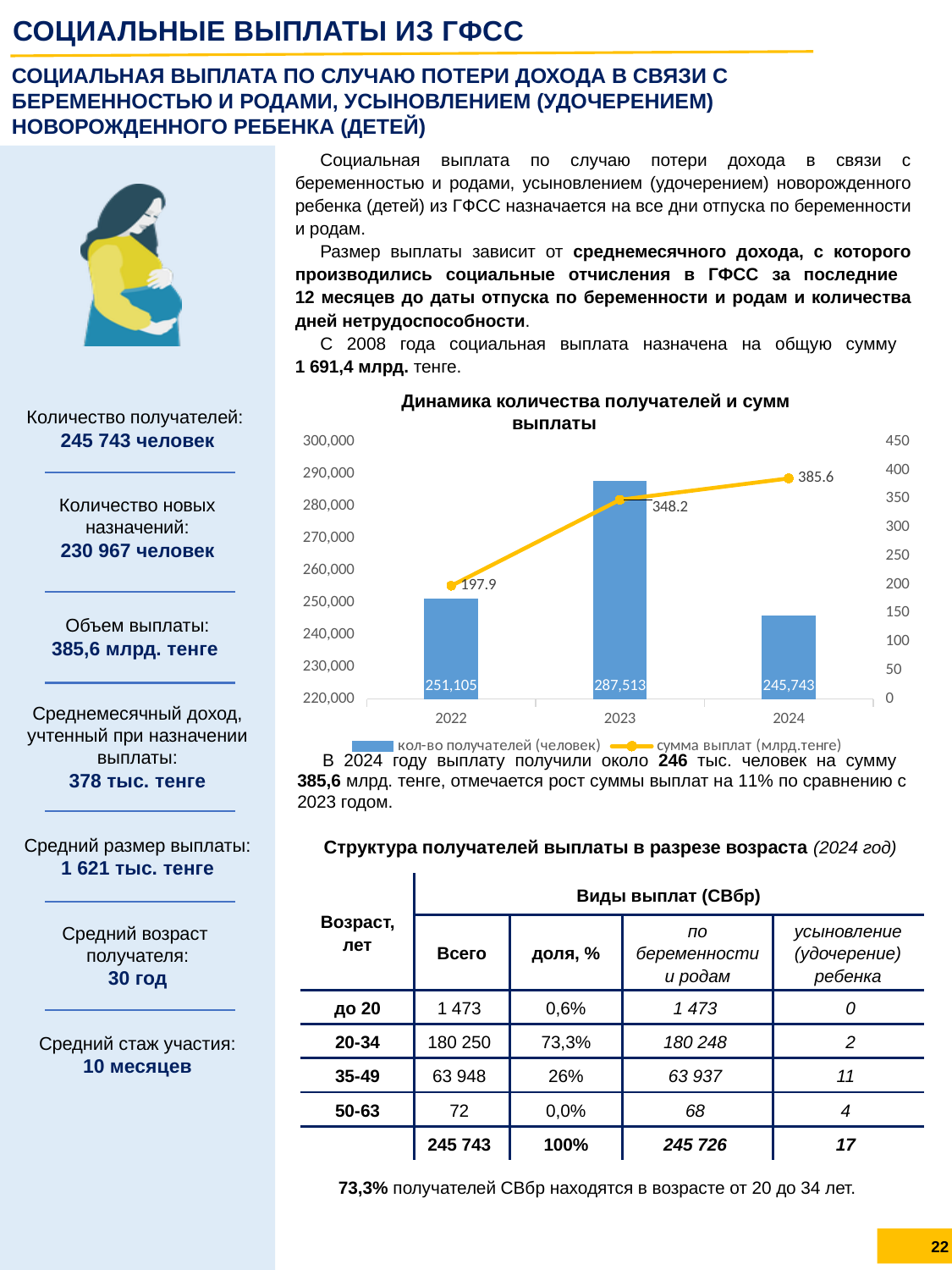
Is the number of recipients larger in 2022 or in 2024? 2022 What is the difference between сумма выплат in 2024 and in 2023? 37.4 Which year has the lowest number of recipients in the chart? 2024 How many series does the chart legend list? 2 What is the value of сумма выплат (млрд.тенге) for 2024 in the chart? 385.6 Which year has the highest number of recipients in the chart? 2023 Which year has the lowest сумма выплат value in the chart? 2022 What is the value of сумма выплат (млрд.тенге) for 2022 in the chart? 197.9 What is the difference between the number of recipients in 2023 and in 2024? 41,770 What is the number of recipients (кол-во получателей) shown for 2023 in the chart? 287,513 Does the сумма выплат line rise or fall from 2022 to 2024? rise How many years are shown on the x axis of the chart? 3